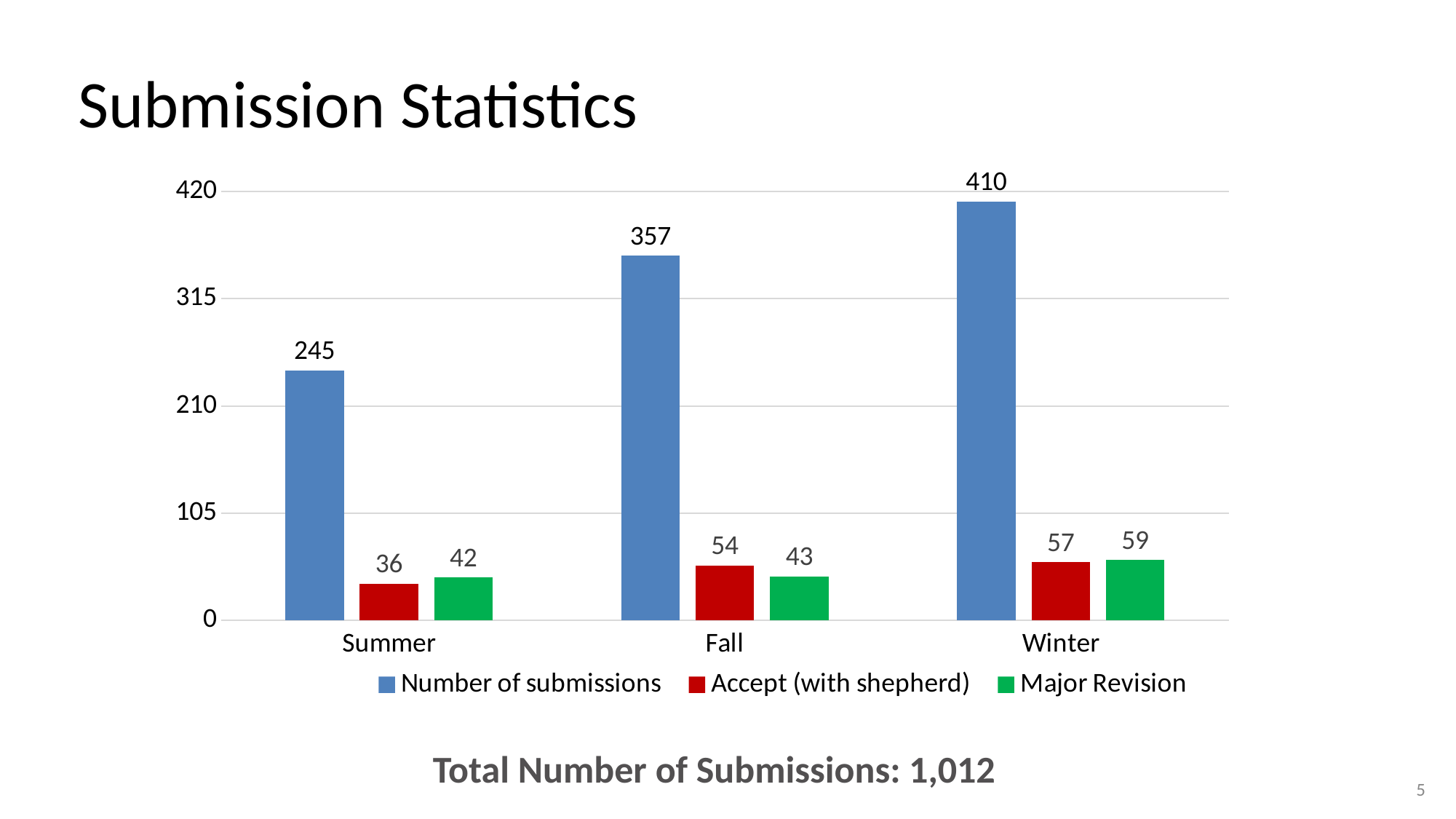
Does the number of submissions rise or fall from Summer to Winter? rise What kind of chart is shown on the slide? bar chart Which season has the lowest Accept (with shepherd) value? Summer Which season has the highest number of submissions? Winter What is the Accept (with shepherd) value for Summer? 36 How many series does the legend list? 3 What is the number of submissions for Fall? 357 Which is larger for Fall: Accept (with shepherd) or Major Revision? Accept (with shepherd) What is the Major Revision value for Winter? 59 Is the number of submissions for Summer greater or less than 210? greater What is the difference in number of submissions between Winter and Summer? 165 How many seasons are shown on the x axis? 3